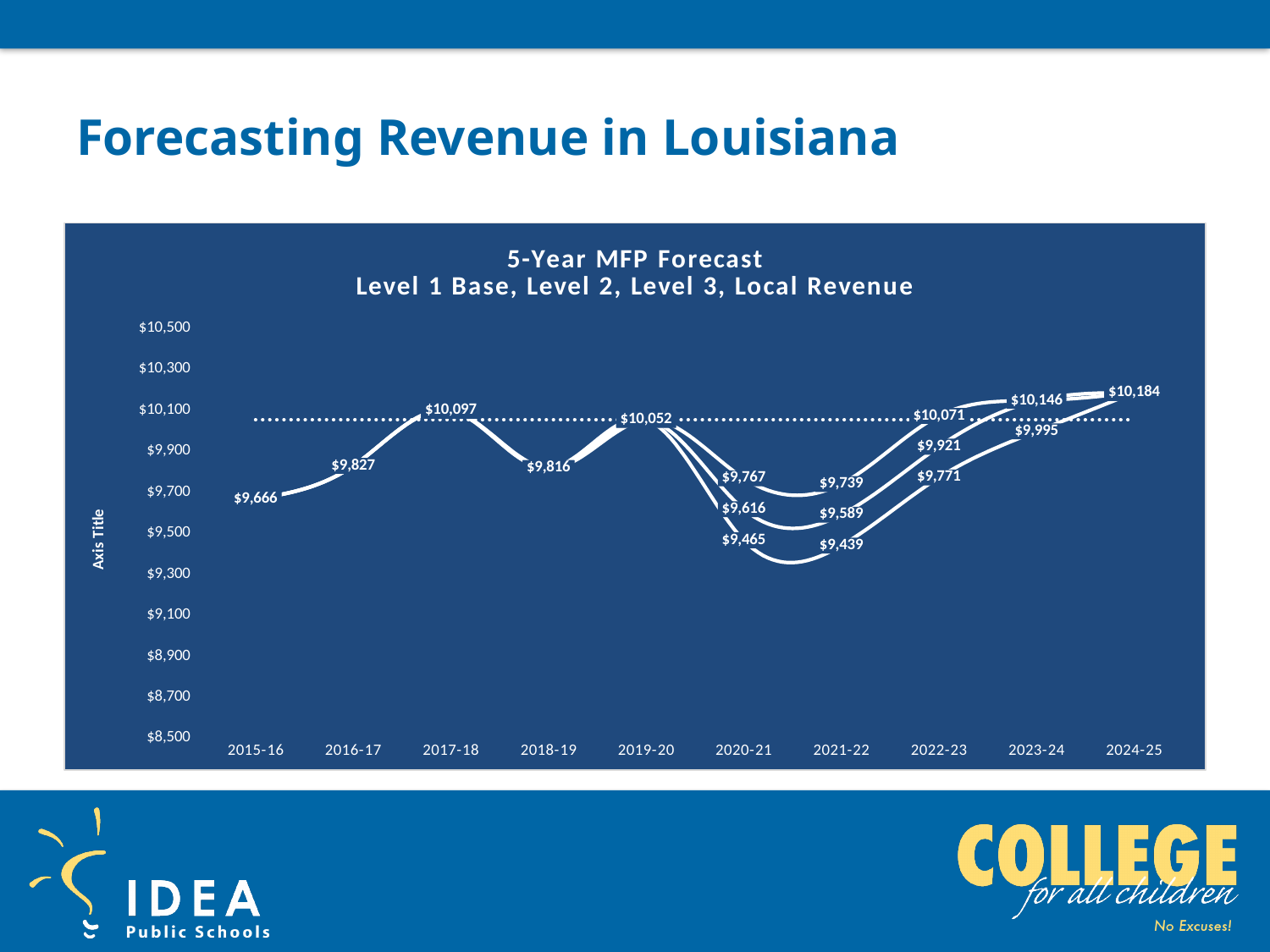
What is the value for 2019-20? $10,052 What is the value for 2015-16? $9,666 What is the lowest value labeled for 2021-22? $9,439 Which is larger, the value for 2016-17 or the value for 2018-19? 2016-17 What is the value for 2024-25? $10,184 Which year has the highest labeled value on the chart? 2024-25 How many years are shown on the x axis? 10 What is the highest value labeled for 2022-23? $10,071 What is the difference between the 2017-18 value and the 2015-16 value? $431 What is the value for 2017-18? $10,097 What type of chart is this? Line chart Which year has the lowest labeled value on the chart? 2021-22